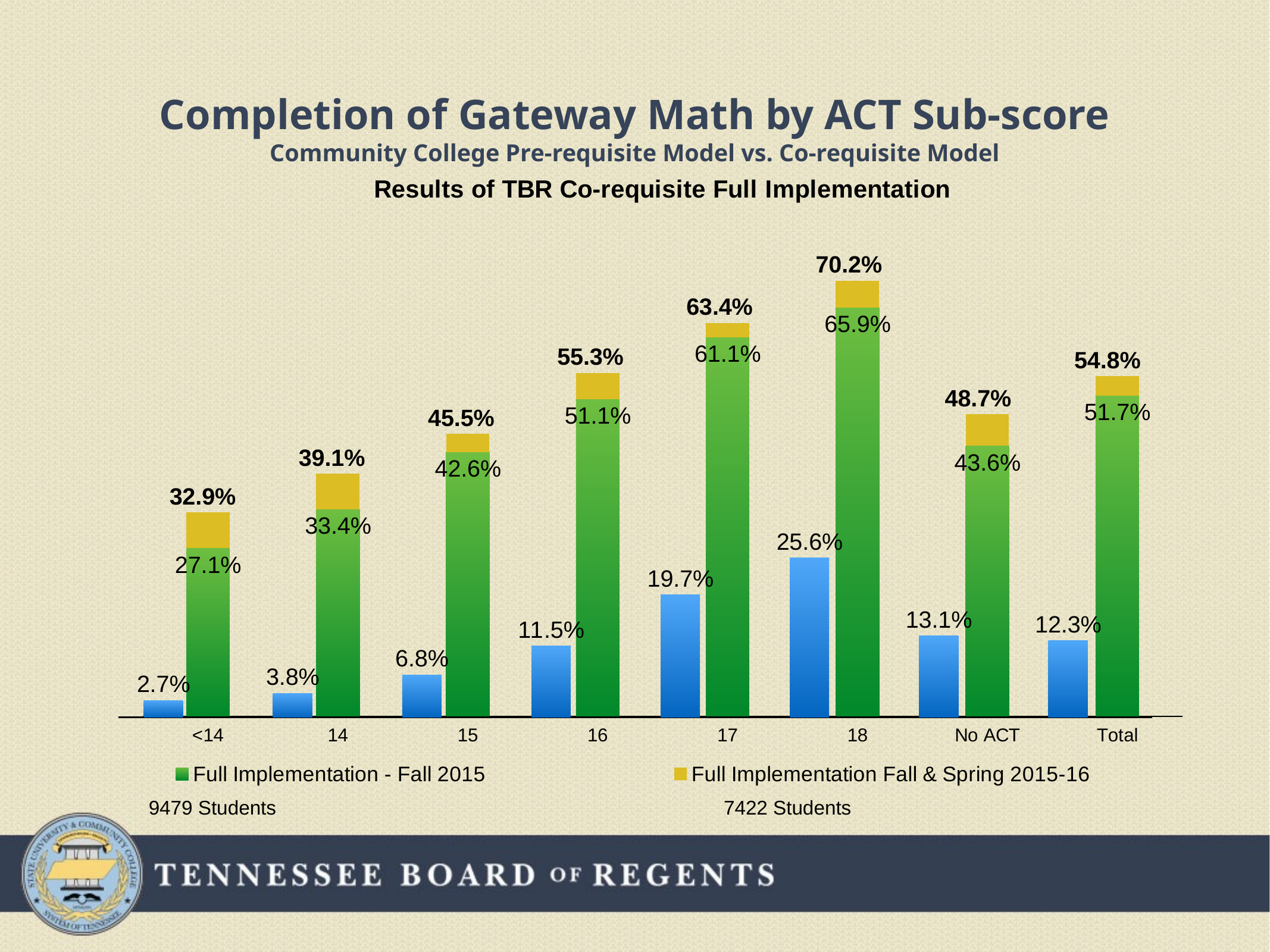
How many series does the legend list? 2 What kind of chart is shown on the slide? Bar chart What is the value of the blue bar for the No ACT category? 13.1% How many categories are shown on the x axis? 8 Which is larger: the blue bar value for ACT sub-score 17 or for No ACT? 17 Which category has the highest Full Implementation - Fall 2015 value? 18 Which category has the lowest blue bar value? <14 What is the bold Full Implementation Fall & Spring 2015-16 value shown above the bar for ACT sub-score 18? 70.2% What is the difference between the Fall & Spring 2015-16 value (70.2%) and the Fall 2015 value (65.9%) for ACT sub-score 18? 4.3% Do the blue bar values rise or fall from <14 to 18 along the x axis? Rise What is the Full Implementation - Fall 2015 value for ACT sub-score 16? 51.1% What is the difference between the Full Implementation - Fall 2015 values for ACT sub-score 18 and <14? 38.8%